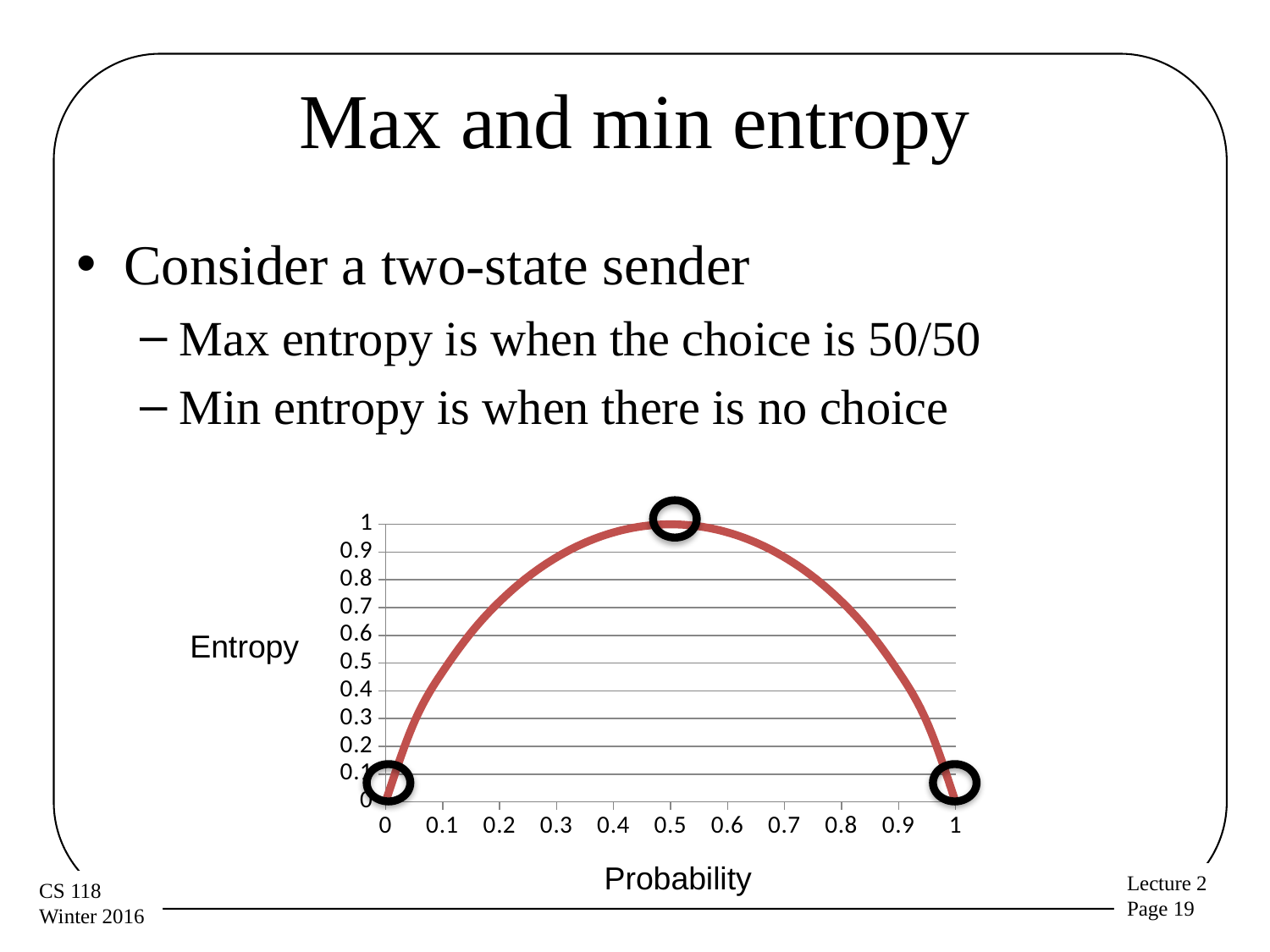
What is the entropy value when the probability is 1? 0 What is the entropy value when the probability is 0.5? 1 What is the entropy value when the probability is 0? 0 Is the entropy at probability 0.9 greater or less than 0.6? less What is the label of the x axis of the chart? Probability Is the entropy at probability 0.1 greater or less than 0.3? greater Is the entropy at probability 0.3 greater or less than 0.8? greater What is the label of the y axis of the chart? Entropy What kind of chart is shown on the slide? line chart Does the entropy rise or fall as probability increases from 0.5 to 1? fall Does the entropy rise or fall as probability increases from 0 to 0.5? rise At which probability does the entropy curve reach its highest value? 0.5